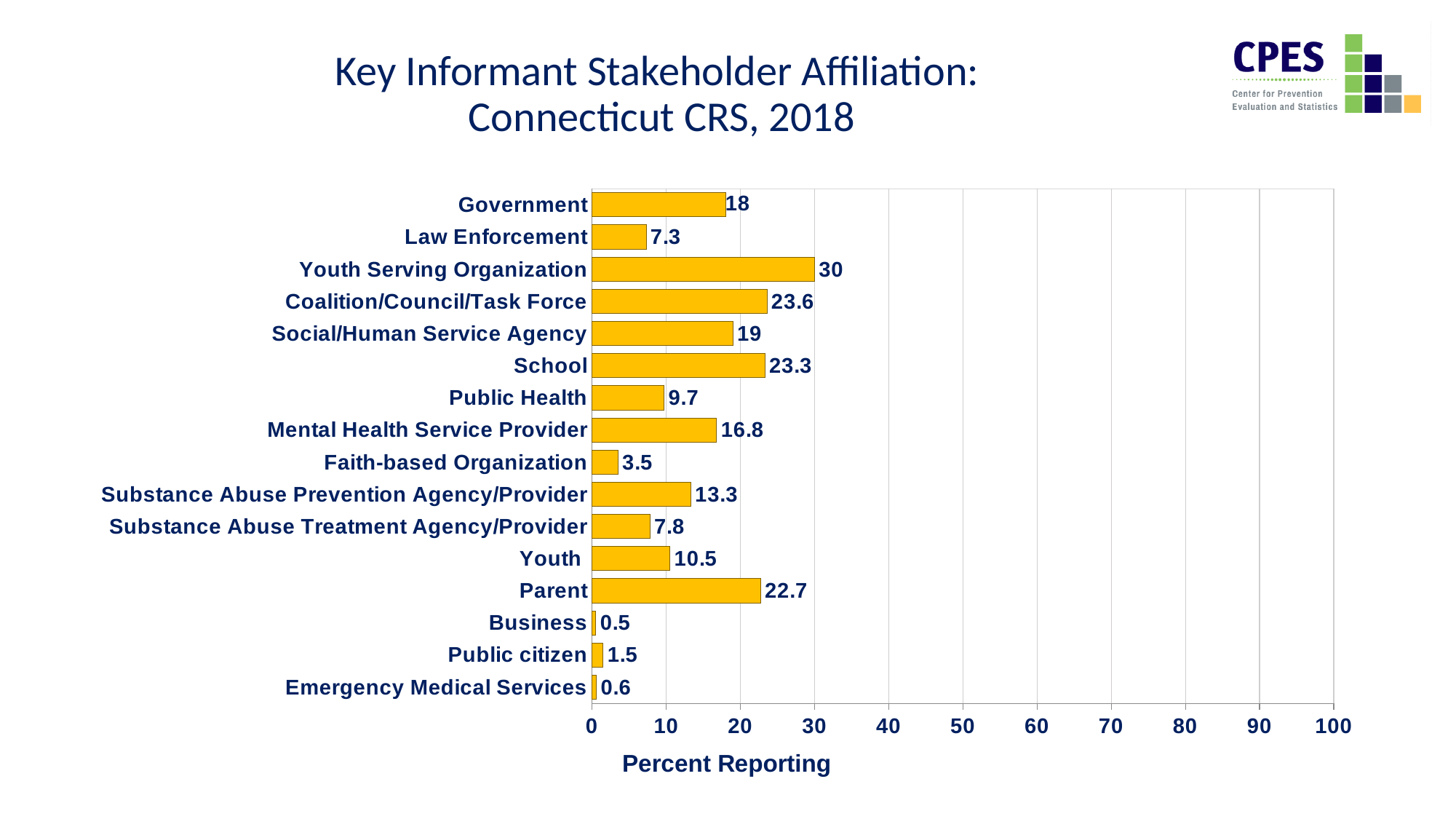
Which stakeholder affiliation has the highest percent reporting? Youth Serving Organization What is the label of the horizontal axis? Percent Reporting Is the percent reporting for Substance Abuse Prevention Agency/Provider greater or less than 10? greater What is the percent reporting for Substance Abuse Treatment Agency/Provider? 7.8 How many stakeholder affiliation categories are shown in the chart? 16 What is the difference in percent reporting between Coalition/Council/Task Force and School? 0.3 What is the percent reporting for Youth Serving Organization? 30 What kind of chart is shown on the slide? Bar chart Which has a higher percent reporting, Parent or Social/Human Service Agency? Parent What is the difference in percent reporting between Government and Law Enforcement? 10.7 What is the percent reporting for Mental Health Service Provider? 16.8 Which stakeholder affiliation has the lowest percent reporting? Business